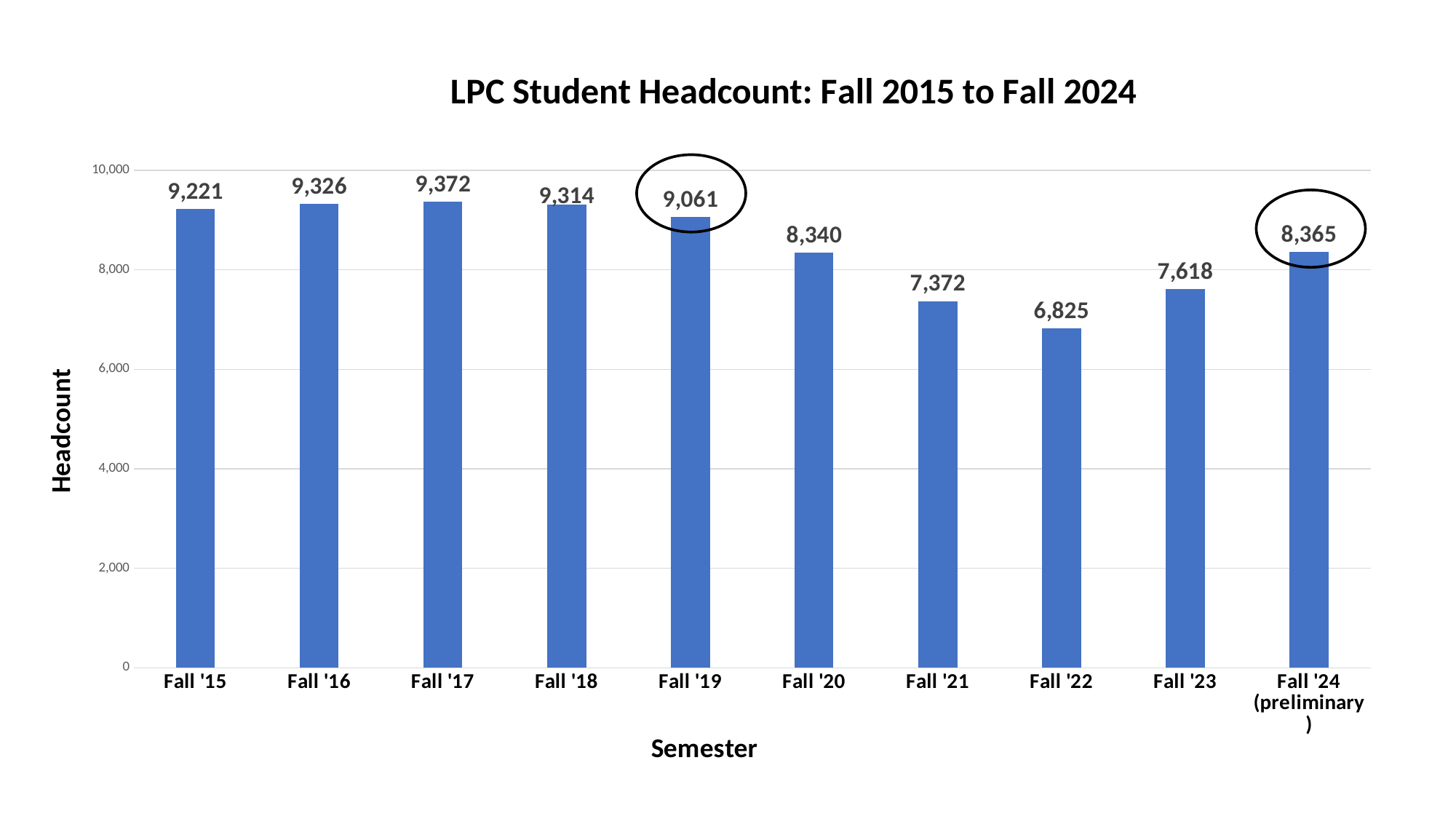
Which semester has the lowest headcount? Fall '22 What is the student headcount for Fall '22? 6,825 What is the difference in headcount between Fall '23 and Fall '22? 793 Is the headcount for Fall '21 greater or less than 8,000? less What is the difference in headcount between Fall '19 and Fall '24 (preliminary)? 696 Which semester has the highest headcount? Fall '17 What is the student headcount for Fall '19? 9,061 What kind of chart is shown on the slide? bar chart What is the title of the chart? LPC Student Headcount: Fall 2015 to Fall 2024 What is the student headcount for Fall '24 (preliminary)? 8,365 Which has a larger headcount, Fall '20 or Fall '24 (preliminary)? Fall '24 (preliminary) How many semesters are shown on the chart? 10